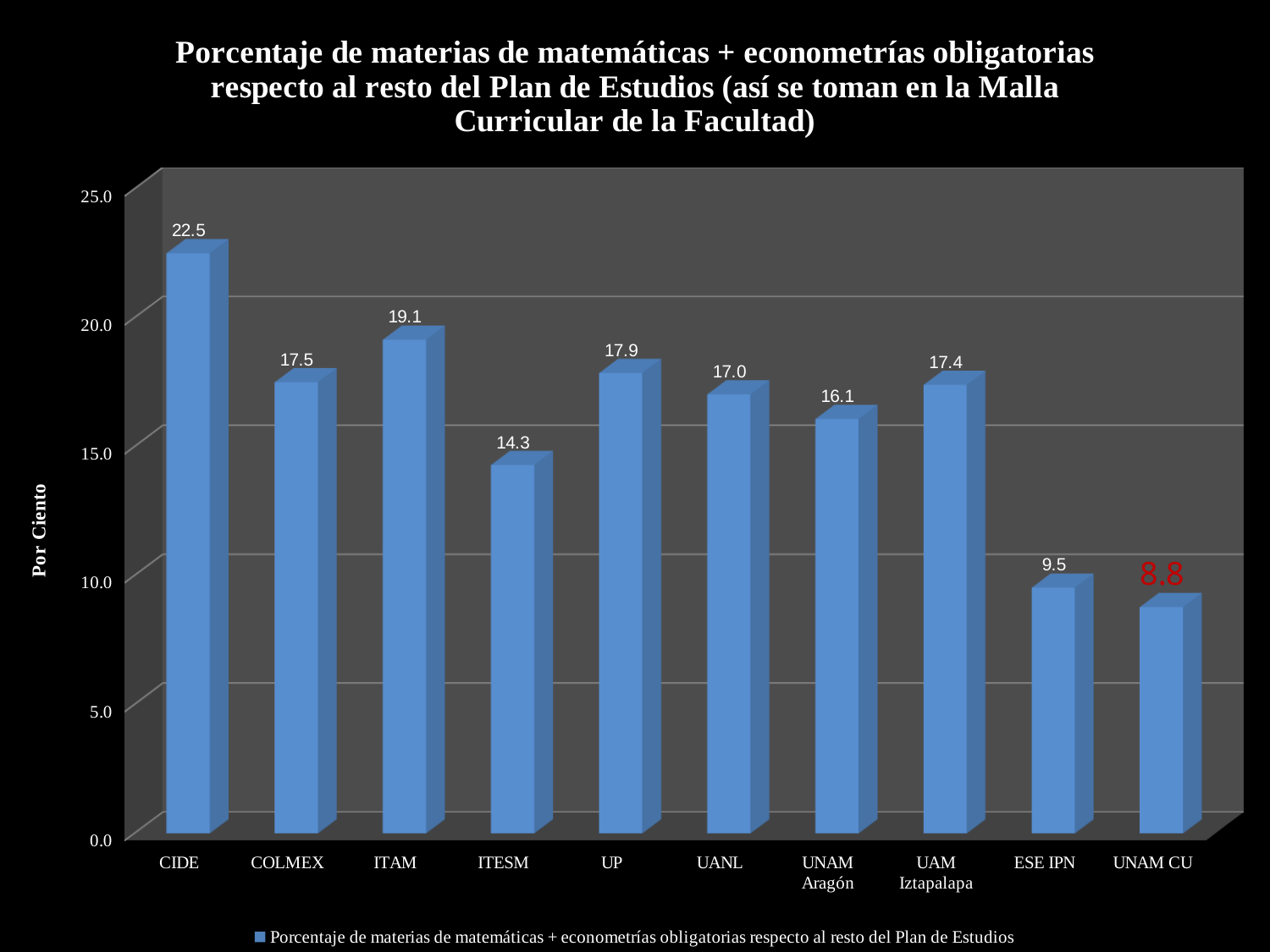
Which institution has the highest value? CIDE What is the difference between the values for ESE IPN and UNAM CU? 0.7 What is the value for CIDE? 22.5 Which institution has the lowest value? UNAM CU What is the value for ITESM? 14.3 What is the label on the vertical axis? Por Ciento What is the difference between the values for CIDE and ITAM? 3.4 What is the value for UAM Iztapalapa? 17.4 What kind of chart is this? Bar chart Which has a larger value, UP or UANL? UP What is the value for UNAM CU? 8.8 How many institutions are shown on the x axis? 10